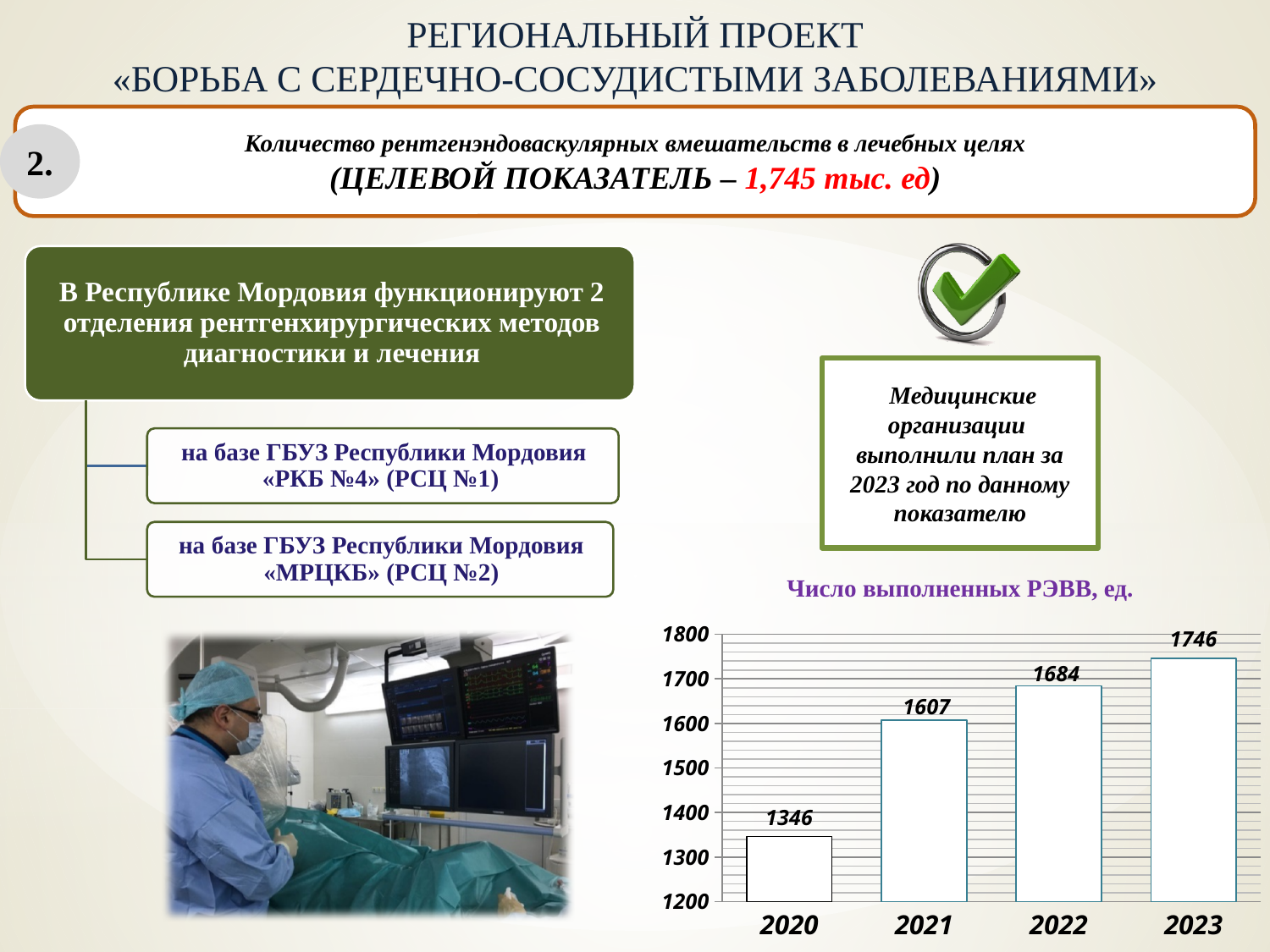
What kind of chart is shown on the slide? bar chart Which year has the lowest value in the chart? 2020 Do the values rise or fall from 2020 to 2023? rise Which year has the highest value in the chart? 2023 What is the value for 2022 in the chart? 1684 What is the difference between the values for 2022 and 2021? 77 What is the difference between the values for 2023 and 2020? 400 Which is larger, the value for 2021 or the value for 2022? 2022 What is the value for 2023 in the chart? 1746 What is the value for 2021 in the chart? 1607 How many years are shown on the x axis of the chart? 4 What is the value for 2020 in the chart 'Число выполненных РЭВВ, ед.'? 1346